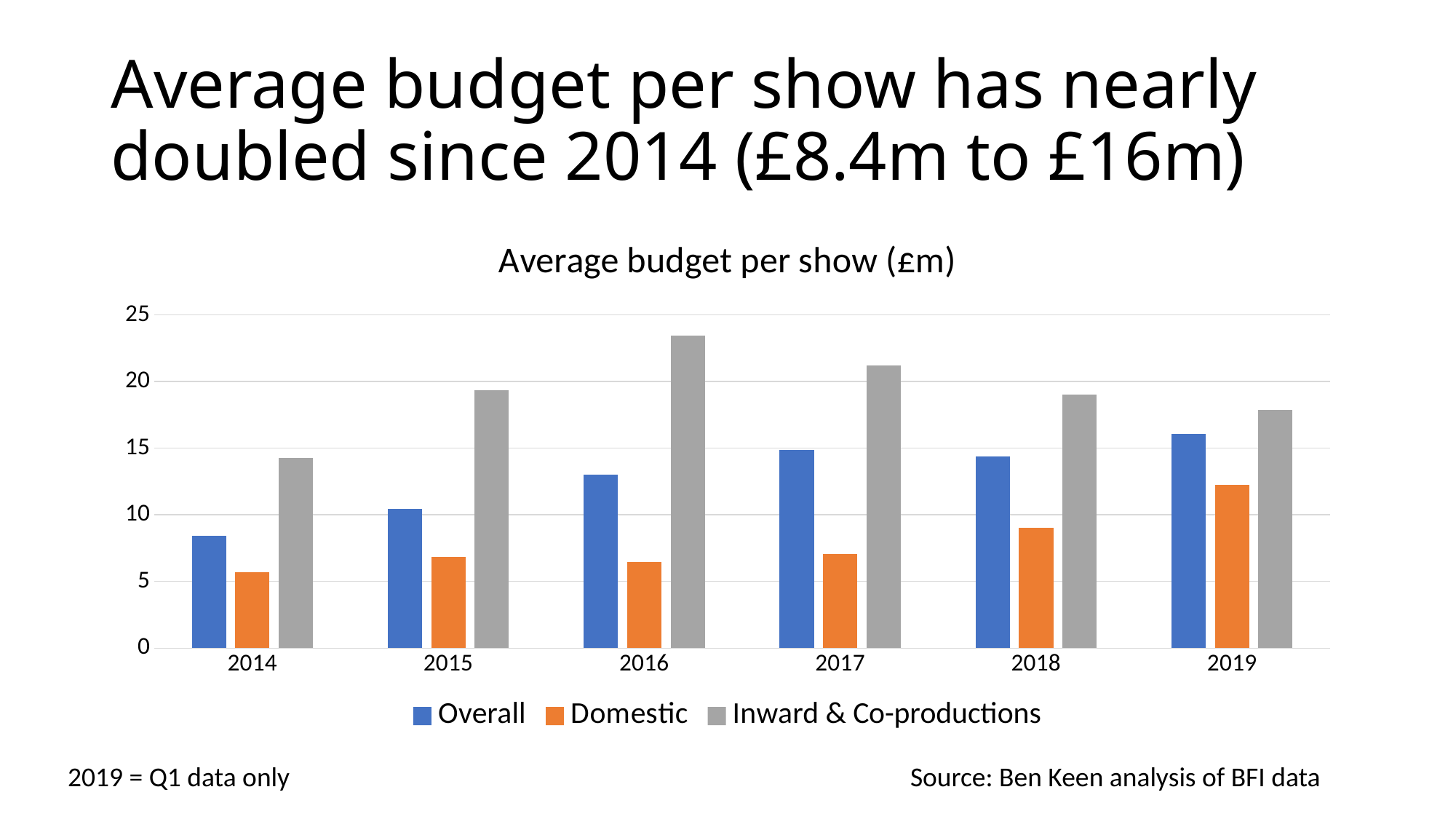
Is the Inward & Co-productions value for 2014 greater or less than 15? less In which year is the Inward & Co-productions average budget highest? 2016 What kind of chart is shown on the slide? Bar chart Is the Inward & Co-productions value for 2016 greater or less than 20? greater Does the Inward & Co-productions series rise or fall from 2016 to 2019? Fall In which year is the Overall average budget highest? 2019 How many series does the legend list? 3 Is the Domestic value for 2019 greater or less than 10? greater How many years are shown on the x axis? 6 What is the title of the chart? Average budget per show (£m) Which is larger in 2018: the Domestic value or the Inward & Co-productions value? Inward & Co-productions In which year is the Domestic average budget lowest? 2014